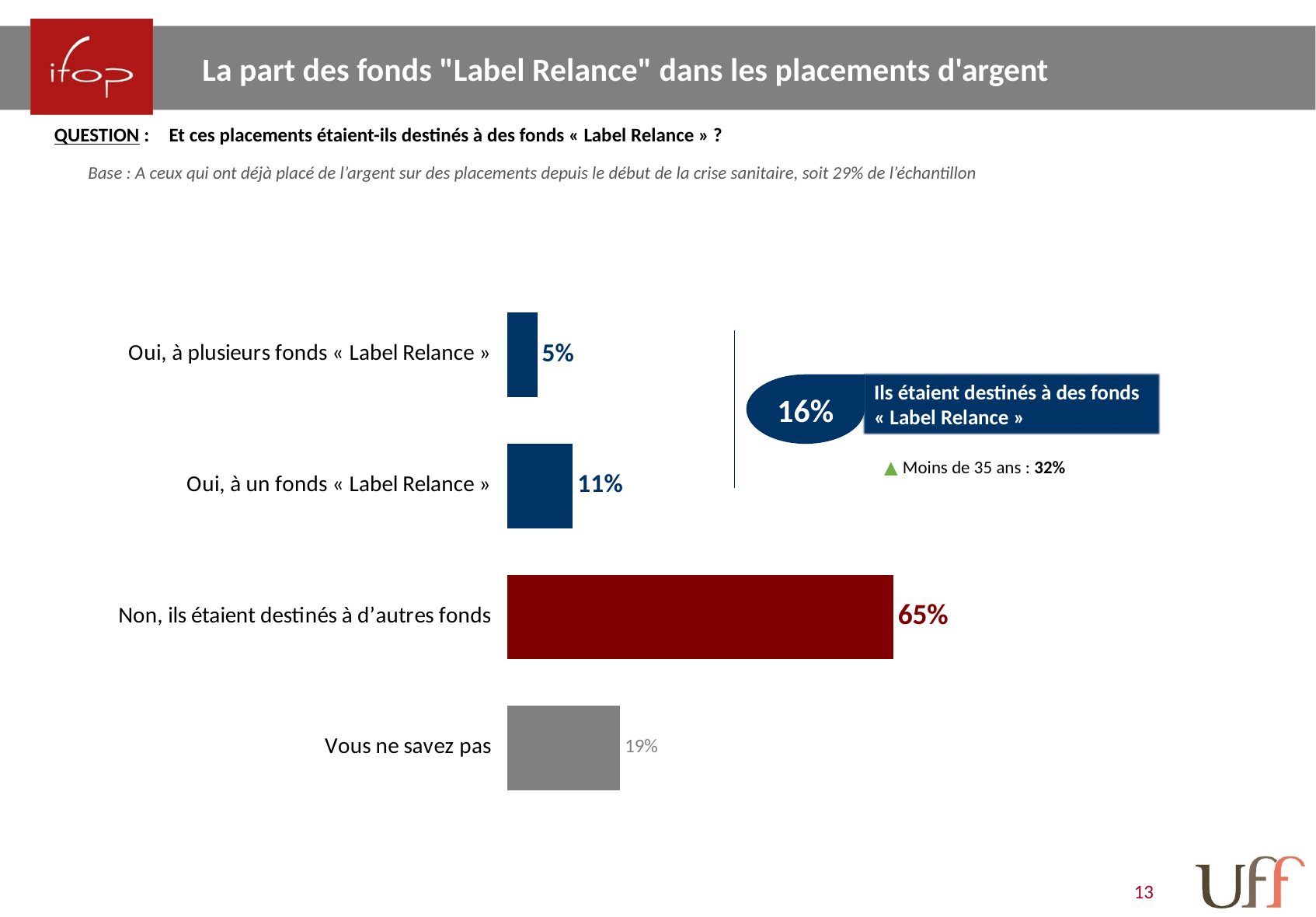
What is the value for "Vous ne savez pas"? 19% What kind of chart is shown on the slide? Bar chart How many categories are shown in the chart? 4 What is the difference between "Oui, à un fonds « Label Relance »" and "Oui, à plusieurs fonds « Label Relance »"? 6% Which category has the lowest value? Oui, à plusieurs fonds « Label Relance » Which category has the highest value? Non, ils étaient destinés à d'autres fonds What is the difference between "Non, ils étaient destinés à d'autres fonds" and "Vous ne savez pas"? 46% Which is larger: "Vous ne savez pas" or "Oui, à un fonds « Label Relance »"? Vous ne savez pas What is the value for "Oui, à plusieurs fonds « Label Relance »"? 5% What is the value for "Oui, à un fonds « Label Relance »"? 11% What is the value for "Non, ils étaient destinés à d'autres fonds"? 65% What combined percentage is shown in the callout for placements destined to "Label Relance" funds? 16%